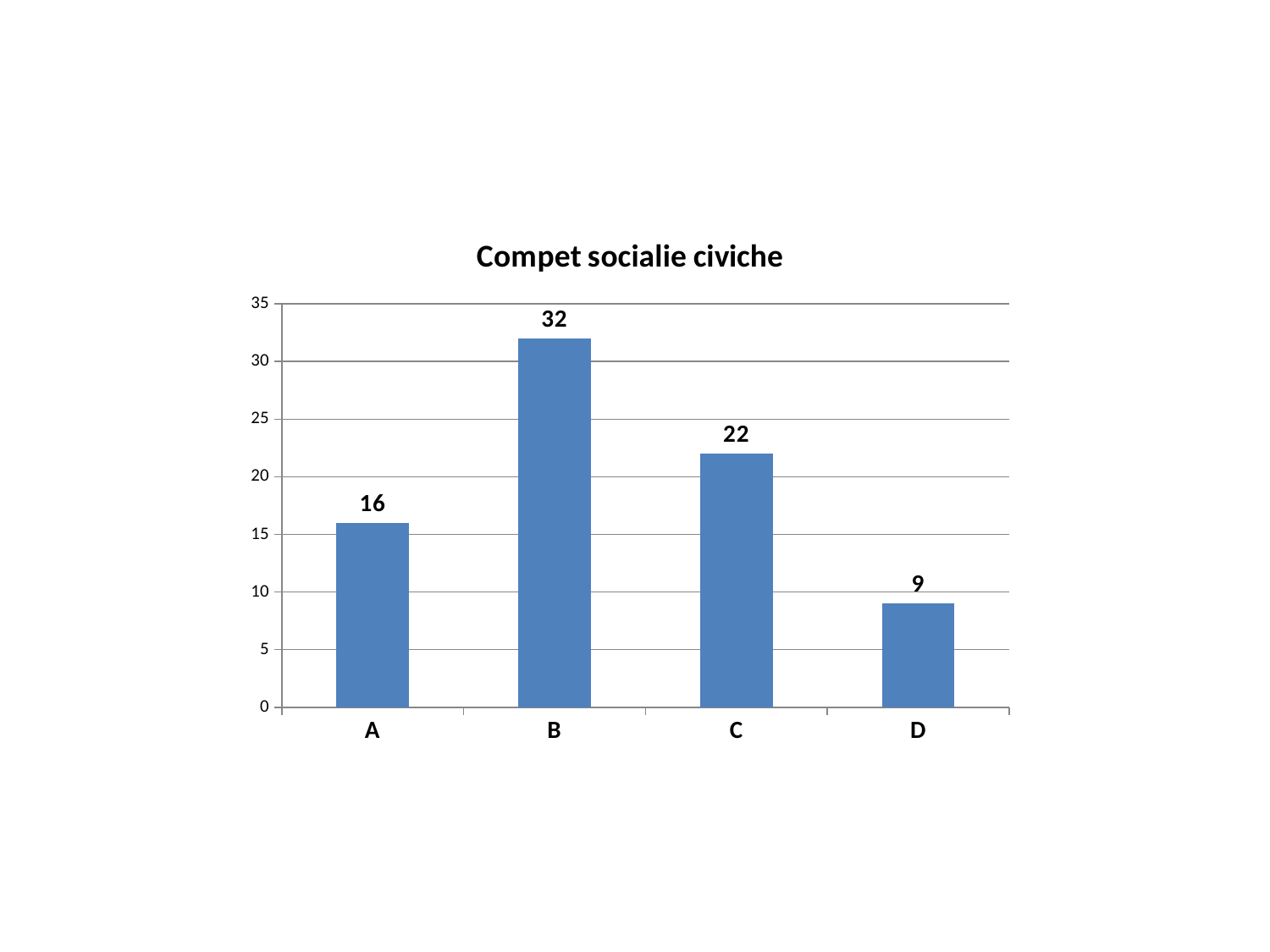
Is the value for C greater or less than 20? greater How many categories are shown on the x axis? 4 Which category has the lowest value? D What is the value for category A? 16 What is the difference between the values for A and D? 7 Which is larger, the value for A or the value for C? C What is the value for category D? 9 What kind of chart is shown on the slide? bar chart What is the difference between the values for B and C? 10 Which category has the highest value? B What is the value for category B? 32 What is the title of the chart? Compet socialie civiche